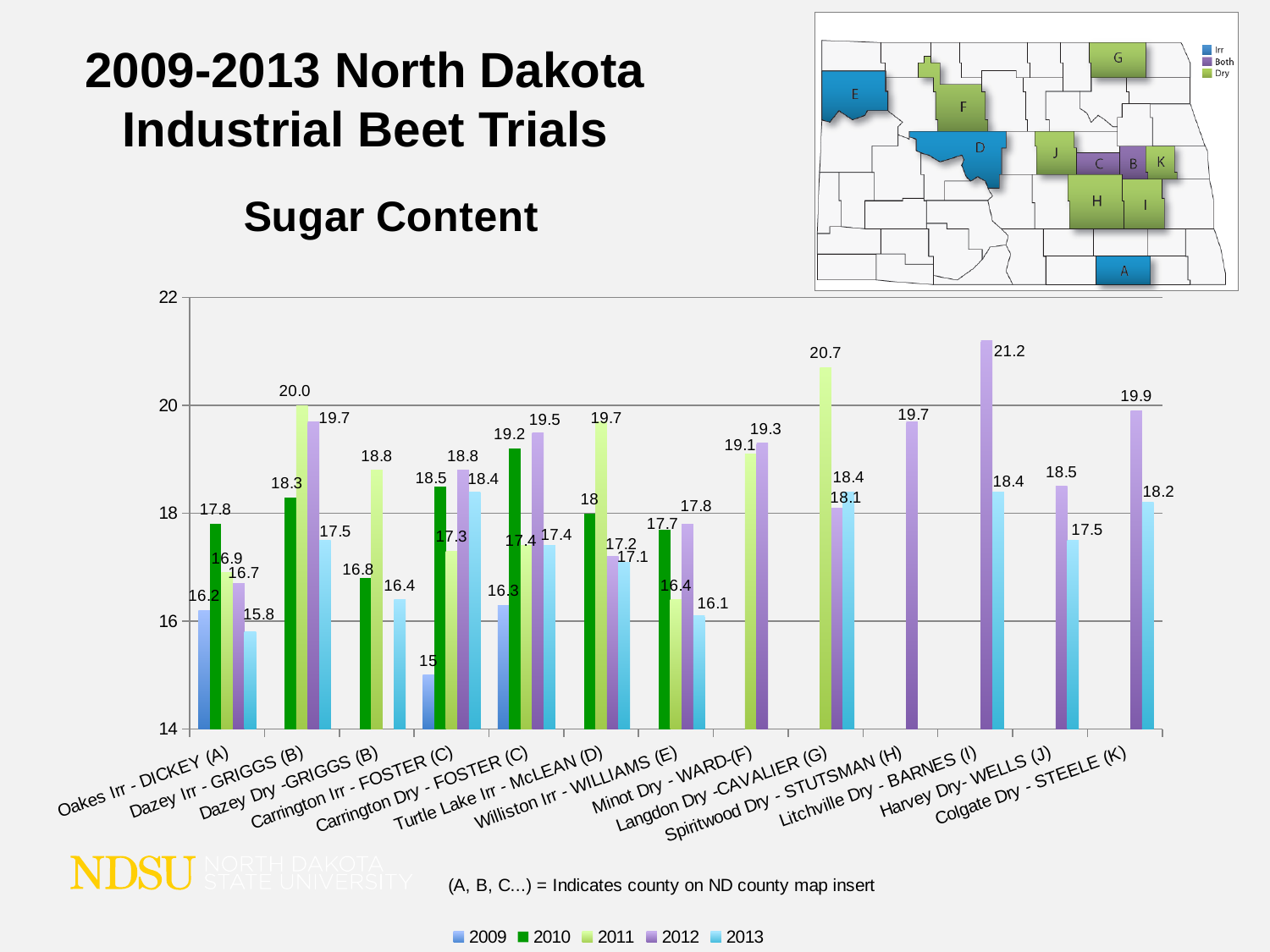
Which is larger for Turtle Lake Irr - McLEAN (D): the 2010 value or the 2011 value? 2011 Which location and year has the lowest sugar content value on the chart? Carrington Irr - FOSTER (C), 2009 What is the 2012 value for Litchville Dry - BARNES (I)? 21.2 How many location categories are shown on the x axis? 13 What is the 2009 value for Carrington Irr - FOSTER (C)? 15 Which location and year has the highest sugar content value on the chart? Litchville Dry - BARNES (I), 2012 What is the difference between the 2011 and 2013 values for Dazey Irr - GRIGGS (B)? 2.5 What type of chart is shown on the slide? bar chart Is the 2012 value for Colgate Dry - STEELE (K) greater or less than 20? less What is the 2011 sugar content value for Langdon Dry - CAVALIER (G)? 20.7 What is the subtitle of the chart below the main title? Sugar Content How many series does the legend list? 5